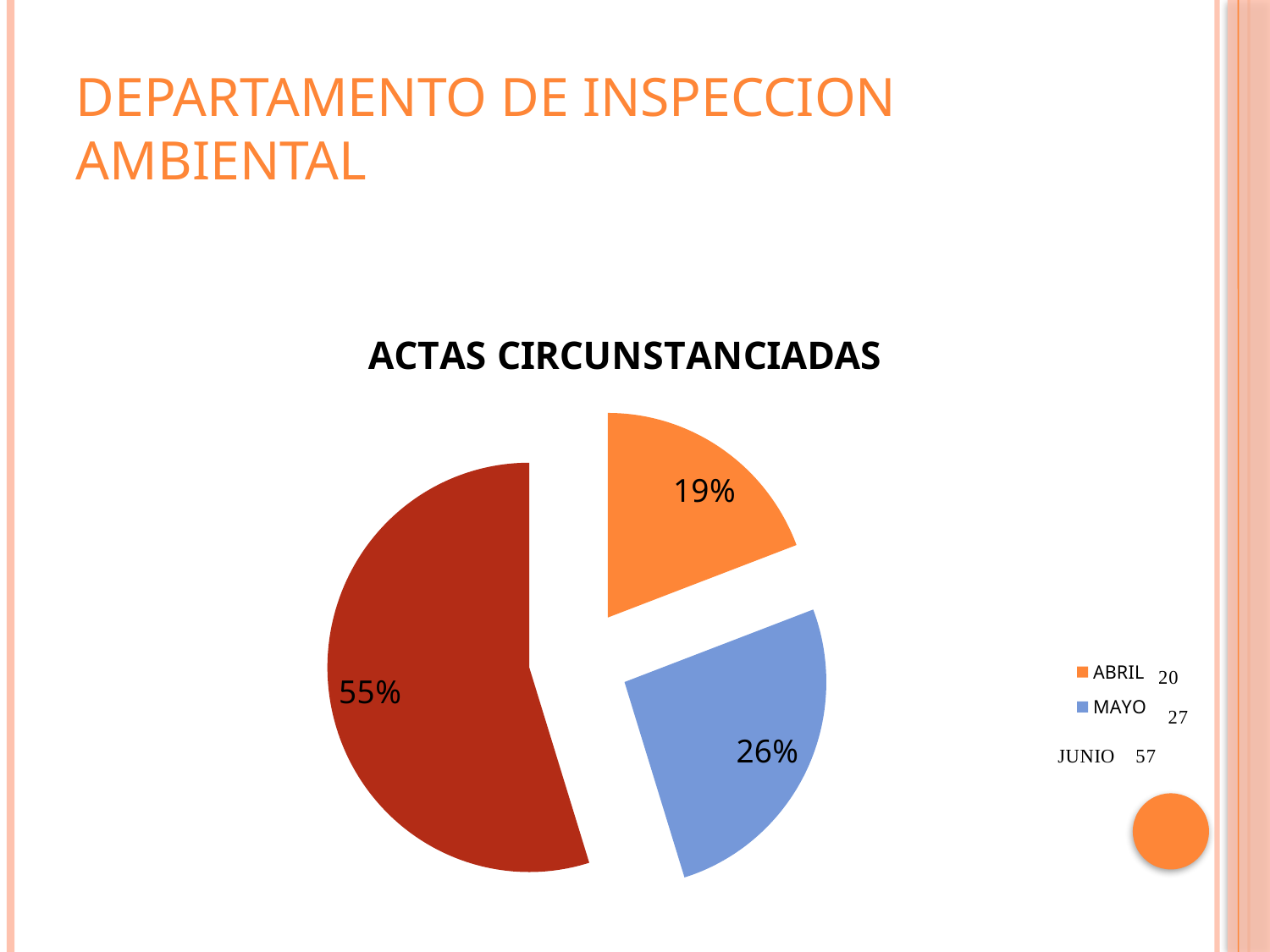
Which month has the smallest slice of the pie? ABRIL Which month has the largest slice of the pie? JUNIO What is the difference in percentage points between the JUNIO slice and the MAYO slice? 29% What type of chart is shown under the title ACTAS CIRCUNSTANCIADAS? Pie chart Which slice is larger, ABRIL or MAYO? MAYO How many slices does the pie chart have? 3 What is the difference in percentage points between the MAYO slice and the ABRIL slice? 7% What share of the pie does the MAYO slice represent? 26% What share of the pie does the ABRIL slice represent? 19% What percentage is shown on the largest (dark red) slice of the pie? 55% What is the title of the chart on the slide? ACTAS CIRCUNSTANCIADAS What colour is the ABRIL slice in the pie chart? Orange